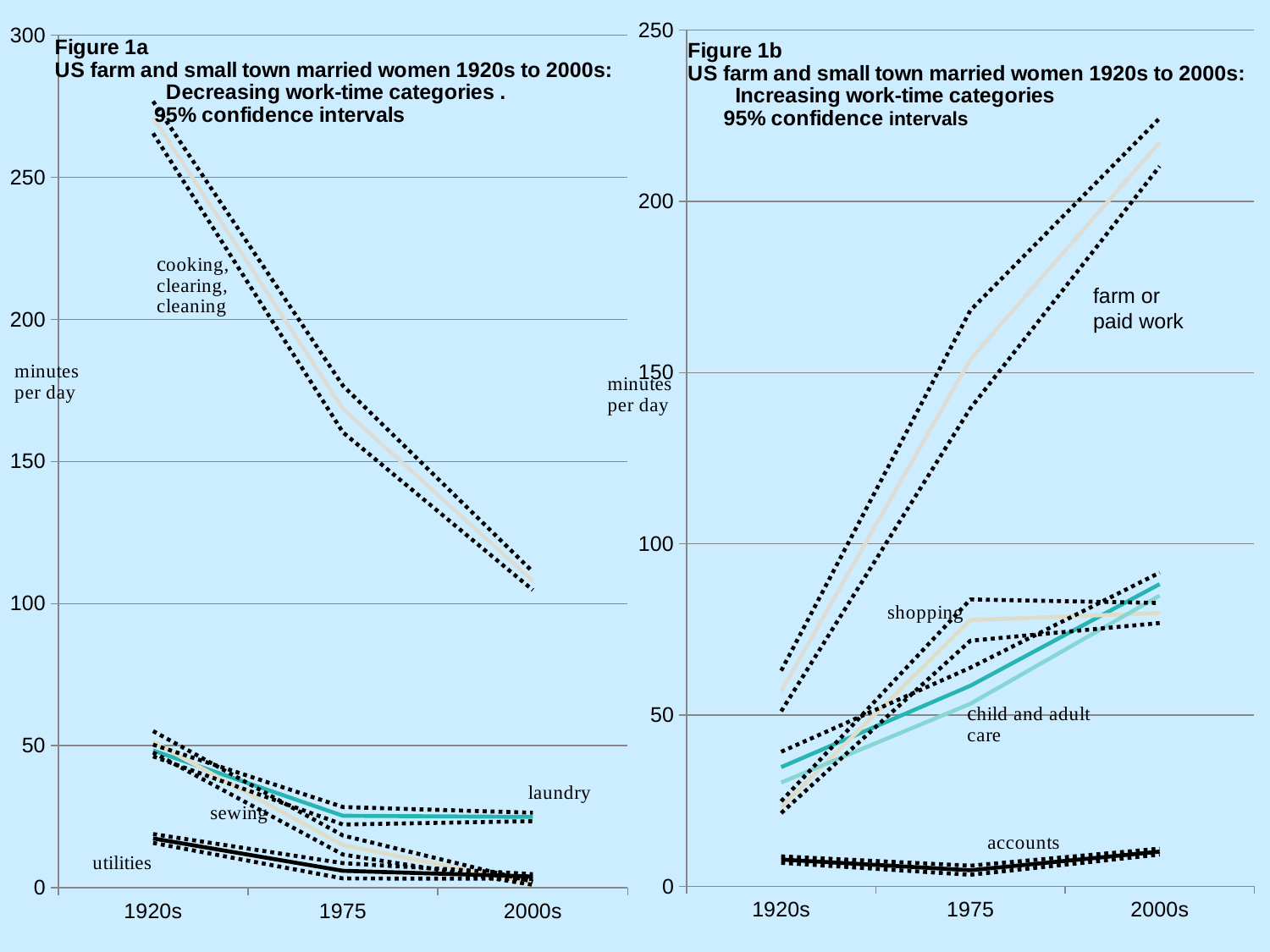
How many time points are shown on the x axis of Figure 1b? 3 In Figure 1b, is the value for accounts in the 2000s greater or less than 50? less In Figure 1a, is the value for cooking, clearing, cleaning in the 1920s greater or less than 250? greater In Figure 1b, is the value for farm or paid work in the 2000s greater or less than 200? greater In Figure 1b, does the time spent on farm or paid work rise or fall from the 1920s to the 2000s? rise What unit is shown on the y axis of Figure 1b? minutes per day In Figure 1a, does the time spent on cooking, clearing, cleaning rise or fall from the 1920s to the 2000s? fall What kind of chart is Figure 1a? line chart In Figure 1a, which category has the highest value in the 1920s? cooking, clearing, cleaning